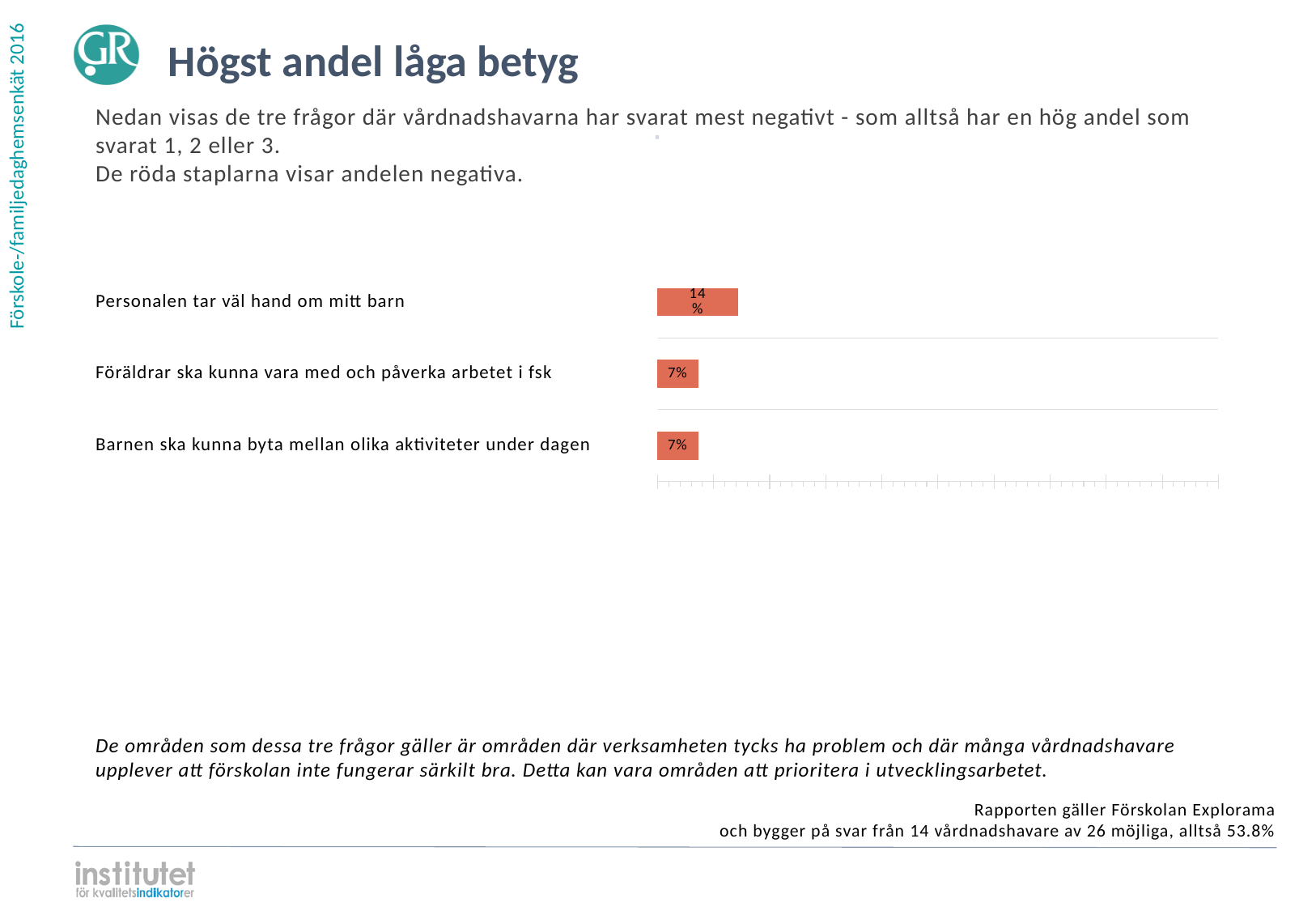
What is the value shown for "Barnen ska kunna byta mellan olika aktiviteter under dagen"? 7% What colour are the bars in the chart? Red What is the value shown for "Föräldrar ska kunna vara med och påverka arbetet i fsk"? 7% What kind of chart is shown on the slide? Bar chart Which category has the highest value in the chart? Personalen tar väl hand om mitt barn What is the difference between the value for "Personalen tar väl hand om mitt barn" and the value for "Föräldrar ska kunna vara med och påverka arbetet i fsk"? 7% Which is larger: the value for "Personalen tar väl hand om mitt barn" or the value for "Barnen ska kunna byta mellan olika aktiviteter under dagen"? Personalen tar väl hand om mitt barn How many categories are shown in the chart? 3 What is the title of the slide containing the chart? Högst andel låga betyg What is the value shown for "Personalen tar väl hand om mitt barn"? 14%